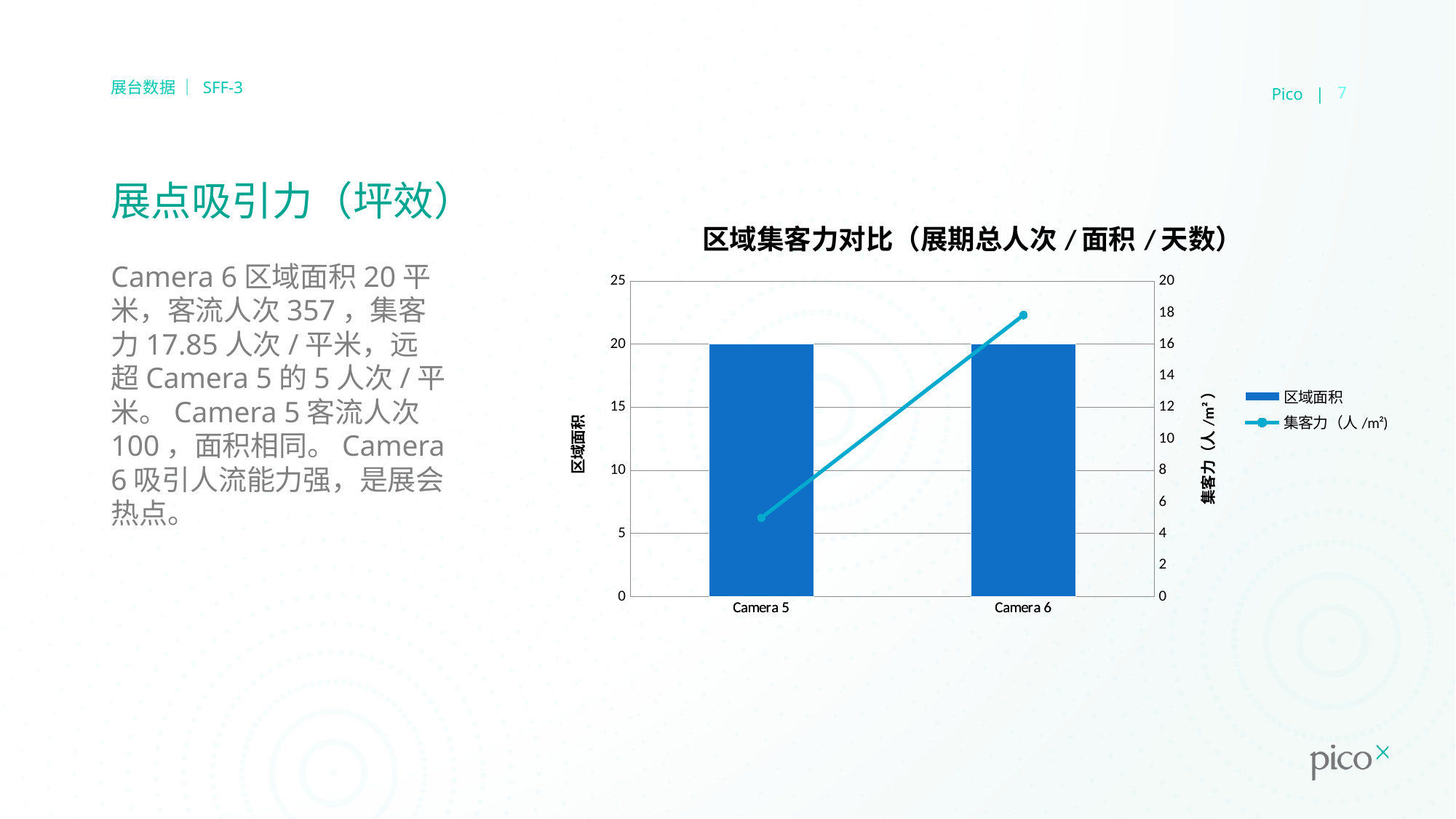
How many series does the chart legend list? 2 What is the 区域面积 value for Camera 6? 20 Which category has the lowest 集客力 (人/m²) value? Camera 5 What is the title of the chart? 区域集客力对比（展期总人次 / 面积 / 天数） Is the 集客力 value for Camera 5 greater or less than 10 on the right axis? less What kind of chart is shown on the slide? Combined bar and line chart Which category has the highest 集客力 (人/m²) value? Camera 6 Is the 集客力 value for Camera 6 greater or less than 16 on the right axis? greater What is the 区域面积 value for Camera 5? 20 Which category has the higher 集客力 (人/m²) value, Camera 5 or Camera 6? Camera 6 Does the 集客力 line rise or fall from Camera 5 to Camera 6? rises How many categories are shown on the x axis of the chart? 2